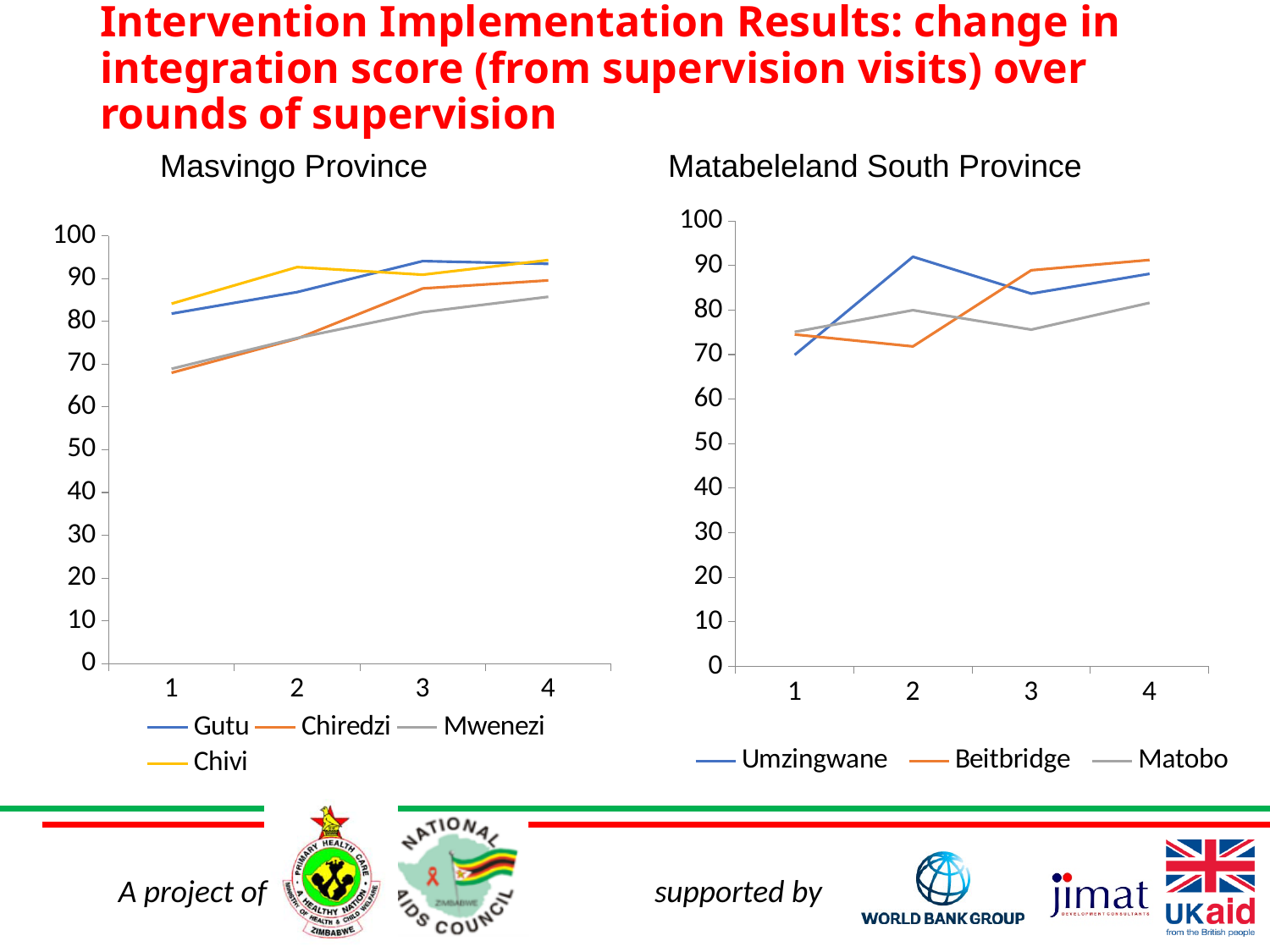
In the Matabeleland South Province chart, is the value for Matobo at round 3 greater or less than 80? less In the Masvingo Province chart, is the value for Chivi at round 2 greater or less than 90? greater In the Masvingo Province chart, does the Mwenezi line rise or fall from round 1 to round 4? Rises How many series does the legend of the Matabeleland South Province chart list? 3 What type of chart is used for the Masvingo Province data? Line chart In the Matabeleland South Province chart, is the value for Umzingwane at round 2 greater or less than 90? greater How many rounds of supervision are shown on the x axis of the Matabeleland South Province chart? 4 In the Matabeleland South Province chart, at round 3, which is higher: Beitbridge or Matobo? Beitbridge In the Masvingo Province chart, which district has the highest integration score at round 1? Chivi In the Matabeleland South Province chart, which district has the lowest integration score at round 4? Matobo How many series does the legend of the Masvingo Province chart list? 4